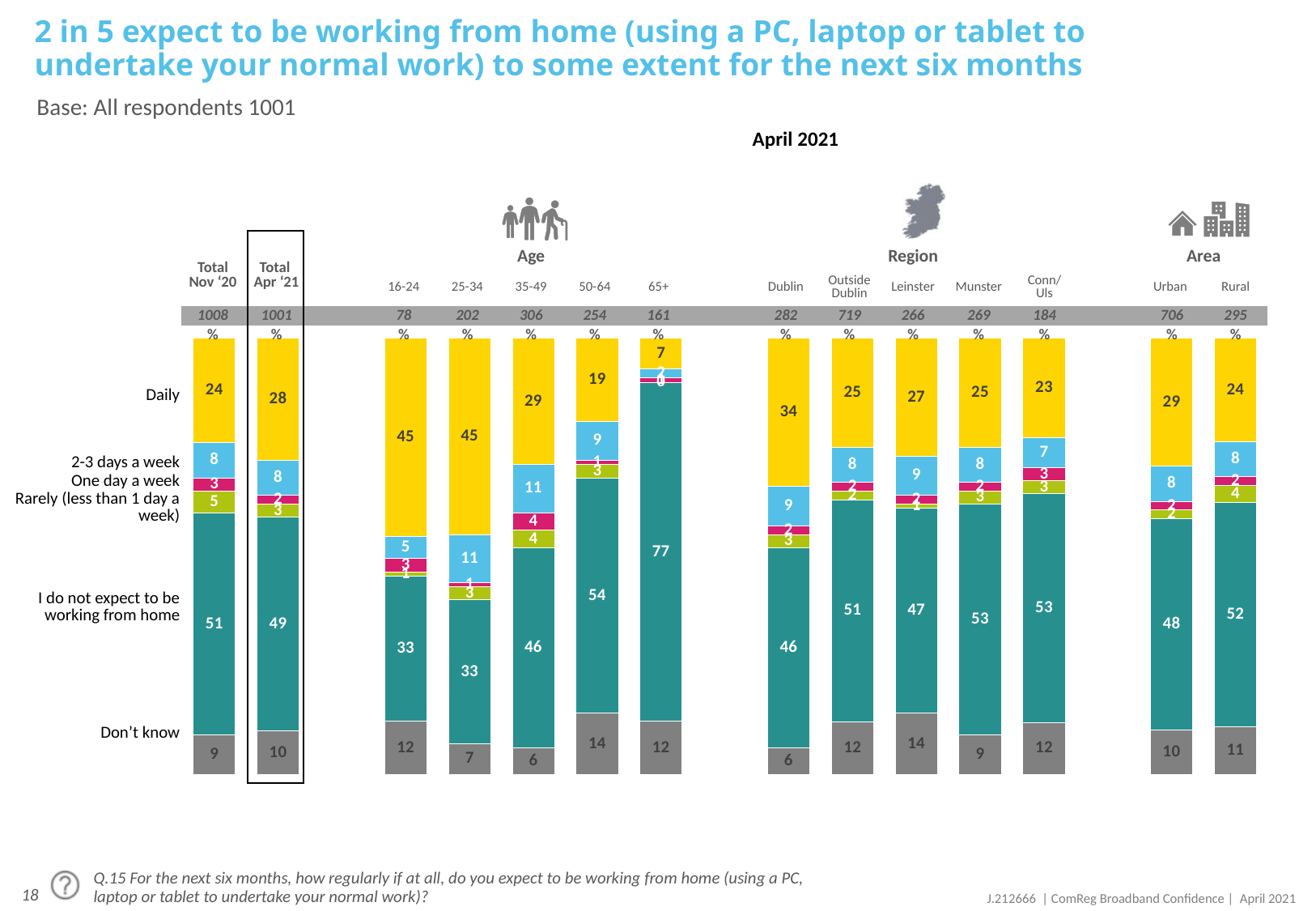
What percentage of 65+ respondents do not expect to be working from home? 77 How many age groups are shown in the chart? 5 What percentage of Total Apr '21 respondents expect to be working from home daily? 28 What is the 'Daily' value for Dublin? 34 What is the base (number of respondents) shown for the 25-34 age group? 202 What is the difference between the 'I do not expect to be working from home' values for Rural and Urban? 4 Which age group has the highest 'I do not expect to be working from home' value? 65+ What is the difference between the 'Daily' values for Total Apr '21 and Total Nov '20? 4 What is the 'Don't know' value for the 50-64 age group? 14 Which is larger, the 'Daily' value for Urban or for Rural? Urban Which region has the lowest 'Don't know' value? Dublin What kind of chart is shown on the slide? Stacked bar chart